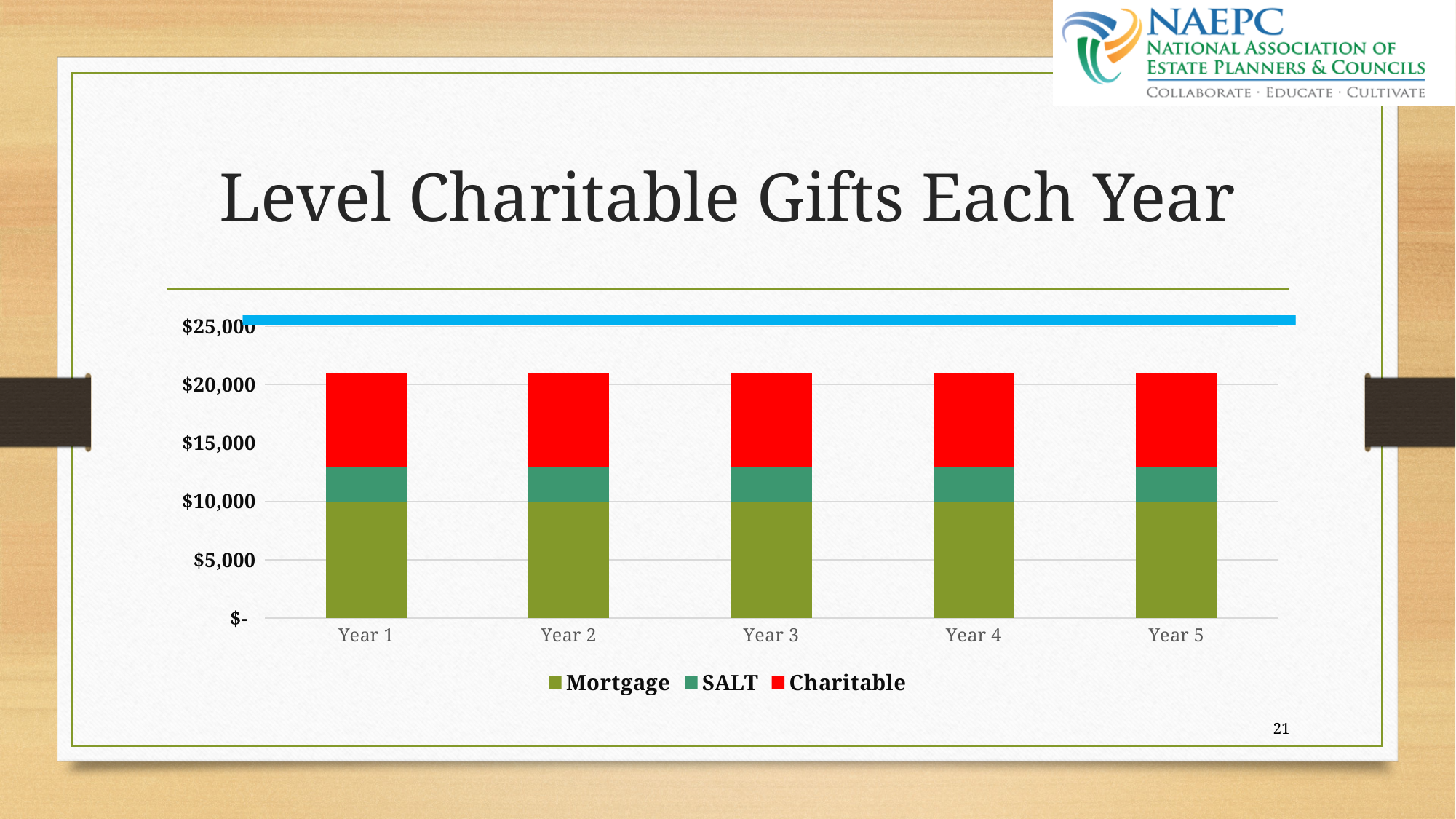
Which series occupies the largest portion of each bar, Mortgage or SALT? Mortgage Do the total bar heights rise, fall, or stay level from Year 1 to Year 5? Stay level How many series does the legend list? 3 Is the top of the SALT segment for Year 4 greater or less than $15,000? less What is the Mortgage value for Year 1? $10,000 Is the total stacked value for Year 2 greater or less than $25,000? less Is the total stacked value for Year 3 greater or less than $20,000? greater What is the title of the chart slide? Level Charitable Gifts Each Year What kind of chart is shown on the slide? Stacked bar chart What is the Mortgage value for Year 5? $10,000 How many years (categories) are shown on the x axis? 5 What are the three series listed in the legend? Mortgage, SALT, Charitable